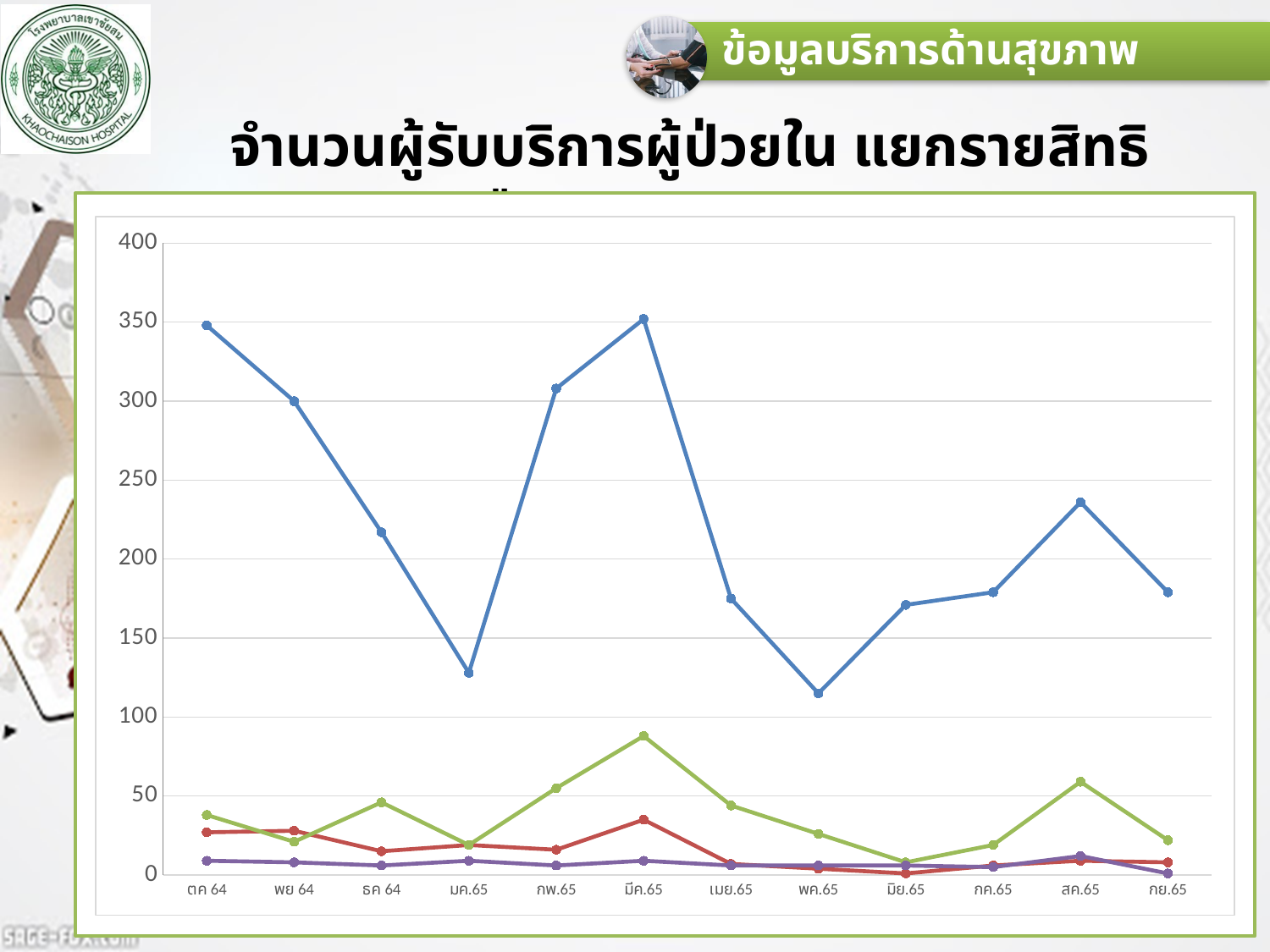
What is the title shown above the chart? จำนวนผู้รับบริการผู้ป่วยใน แยกรายสิทธิ Which is larger for the blue line: the value for ตค 64 or the value for พย 64? ตค 64 Is the value of the blue line for มค.65 greater or less than 150? less How many months are shown along the x axis of the chart? 12 How many lines are plotted on the chart? 4 Is the value of the blue line for ตค 64 greater or less than 300? greater In which month does the green line reach its highest value? มีค.65 Is the value of the blue line for สค.65 greater or less than 200? greater What kind of chart is shown on the slide? line chart In which month does the blue line reach its lowest value? พค.65 Does the blue line rise or fall from ตค 64 to มค.65? fall